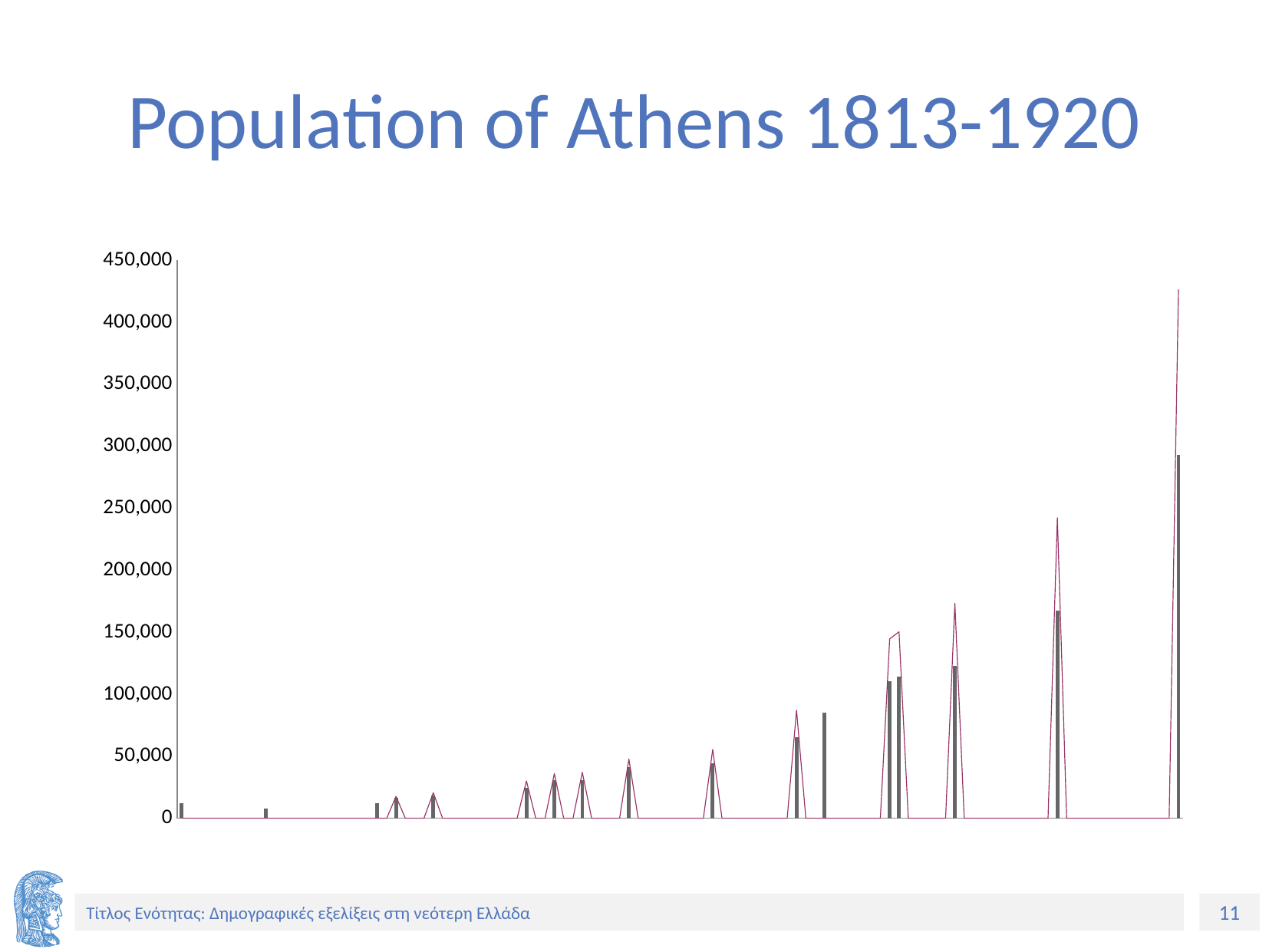
What is the title of the chart? Population of Athens 1813-1920 Is the value of the tallest bar (at the far right) greater or less than 250,000? greater Is the highest point of the line greater or less than 400,000? greater What is the highest value labelled on the vertical axis? 450,000 Do the bar values generally rise or fall from left to right across the chart? rise Is the value of the leftmost bar greater or less than 50,000? less Which reaches higher on the chart, the peak of the line or the tallest bar? the peak of the line What kind of chart is shown on the slide? bar chart (with a line overlay) Which is taller, the rightmost bar or the bar immediately to its left? the rightmost bar Where on the chart is the tallest bar located? at the far right